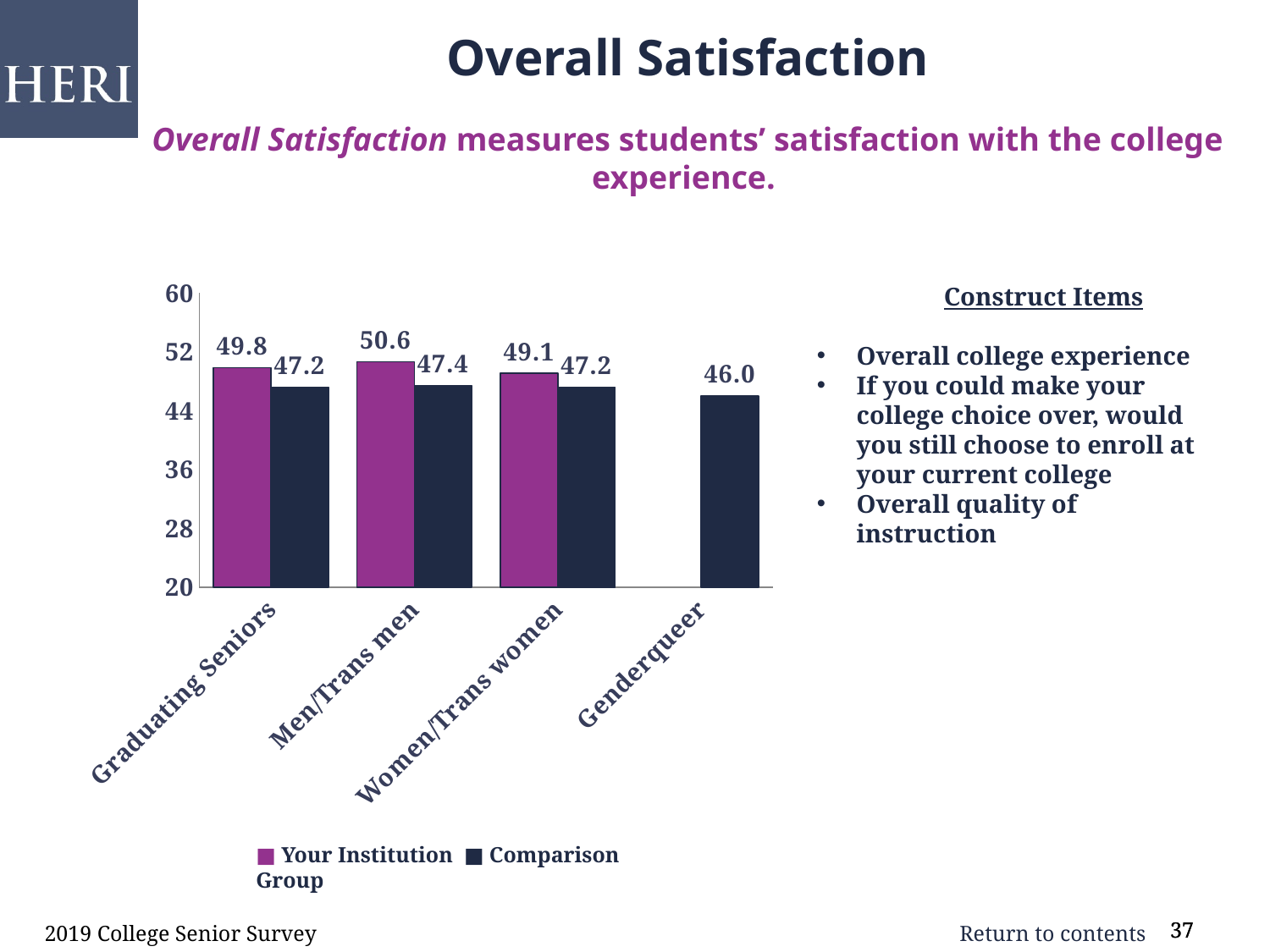
What kind of chart is shown on the slide? Bar chart How many categories are shown on the x axis? 4 What is the Comparison Group value for Genderqueer? 46.0 Which category has the lowest Comparison Group value? Genderqueer Which category has the highest Your Institution value? Men/Trans men Which series is shown in purple? Your Institution What is the Comparison Group value for Men/Trans men? 47.4 Which is larger for Graduating Seniors: the Your Institution value or the Comparison Group value? Your Institution What is the difference between the Your Institution and Comparison Group values for Men/Trans men? 3.2 How many series does the legend list? 2 What is the Your Institution value for Graduating Seniors? 49.8 What is the Your Institution value for Women/Trans women? 49.1